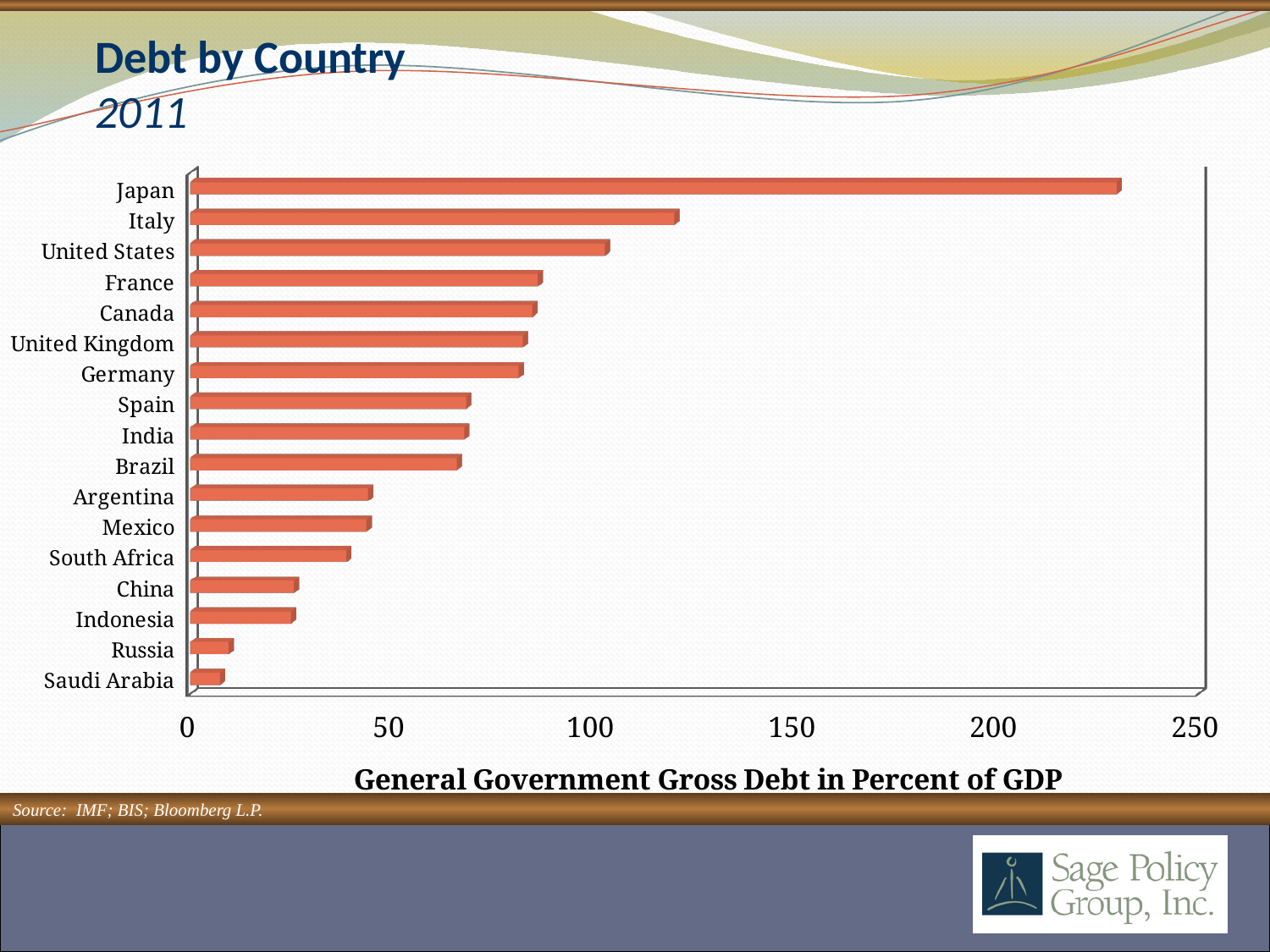
Is the value for France greater or less than 100? less Is the value for Italy greater or less than 100? greater Is the value for Argentina greater or less than 50? less Which has a higher debt-to-GDP value, Brazil or Argentina? Brazil Which country has the lowest general government gross debt as a percent of GDP? Saudi Arabia How many countries are shown in the chart? 17 What kind of chart is shown on the slide? bar chart What is the label on the horizontal axis of the chart? General Government Gross Debt in Percent of GDP Which country has the highest general government gross debt as a percent of GDP? Japan Which has a higher debt-to-GDP value, the United States or Germany? United States What year does the chart title refer to? 2011